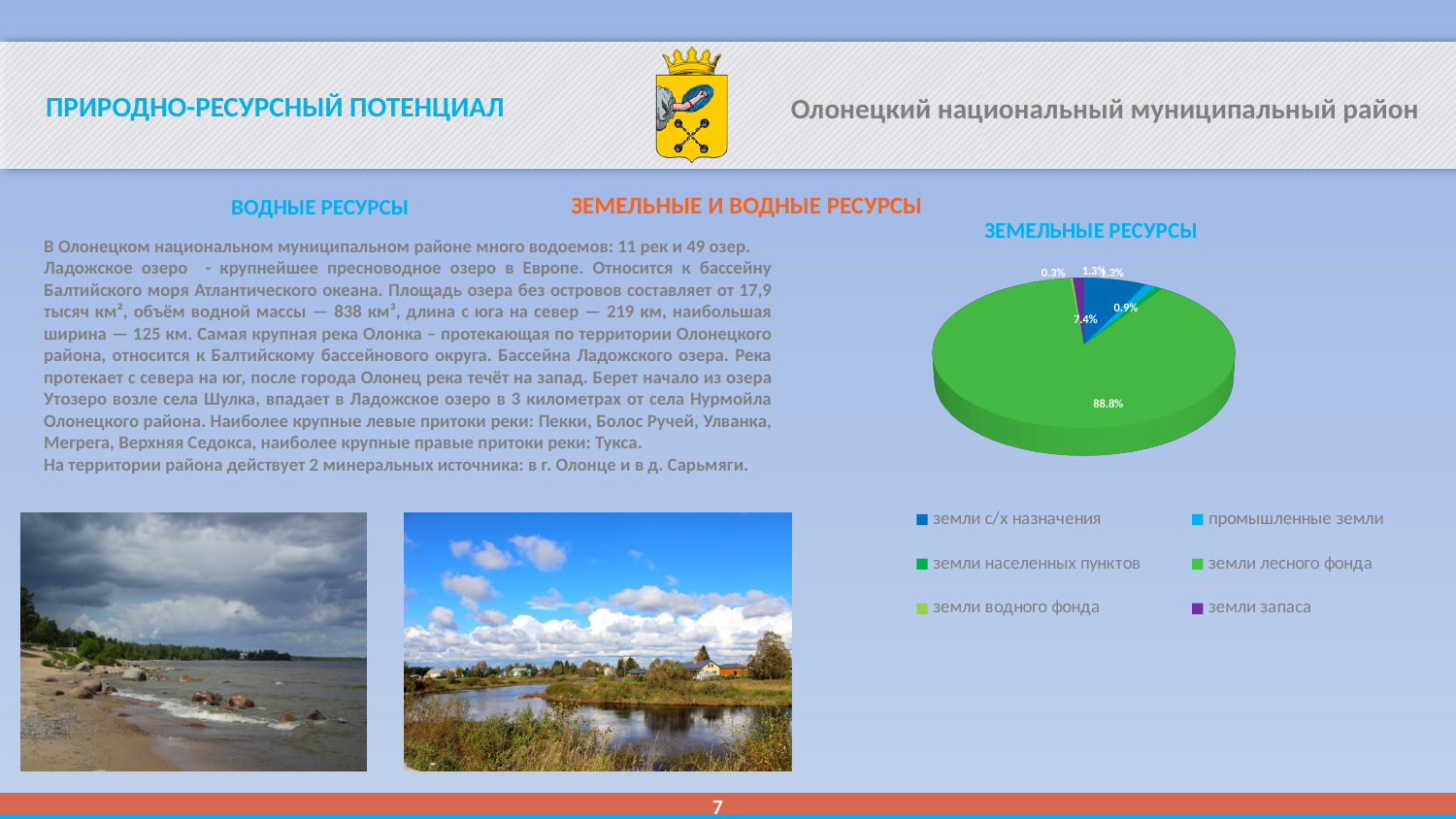
In the ЗЕМЕЛЬНЫЕ РЕСУРСЫ pie chart, what colour is the slice for земли лесного фонда? Green Which category has the largest slice in the ЗЕМЕЛЬНЫЕ РЕСУРСЫ pie chart? земли лесного фонда In the ЗЕМЕЛЬНЫЕ РЕСУРСЫ pie chart, what share is shown for промышленные земли? 1.3% In the ЗЕМЕЛЬНЫЕ РЕСУРСЫ pie chart, what share is shown for земли с/х назначения? 7.4% What is the title of the chart on the right side of the slide? ЗЕМЕЛЬНЫЕ РЕСУРСЫ In the ЗЕМЕЛЬНЫЕ РЕСУРСЫ pie chart, what share is shown for земли лесного фонда? 88.8% In the ЗЕМЕЛЬНЫЕ РЕСУРСЫ pie chart, what share is shown for земли запаса? 1.3% What kind of chart is shown under the heading ЗЕМЕЛЬНЫЕ РЕСУРСЫ? Pie chart Which category has the smallest slice in the ЗЕМЕЛЬНЫЕ РЕСУРСЫ pie chart? земли водного фонда How many categories does the legend of the ЗЕМЕЛЬНЫЕ РЕСУРСЫ pie chart list? 6 In the ЗЕМЕЛЬНЫЕ РЕСУРСЫ pie chart, which is larger: земли с/х назначения or промышленные земли? земли с/х назначения In the ЗЕМЕЛЬНЫЕ РЕСУРСЫ pie chart, by how many percentage points does земли лесного фонда exceed земли с/х назначения? 81.4 percentage points